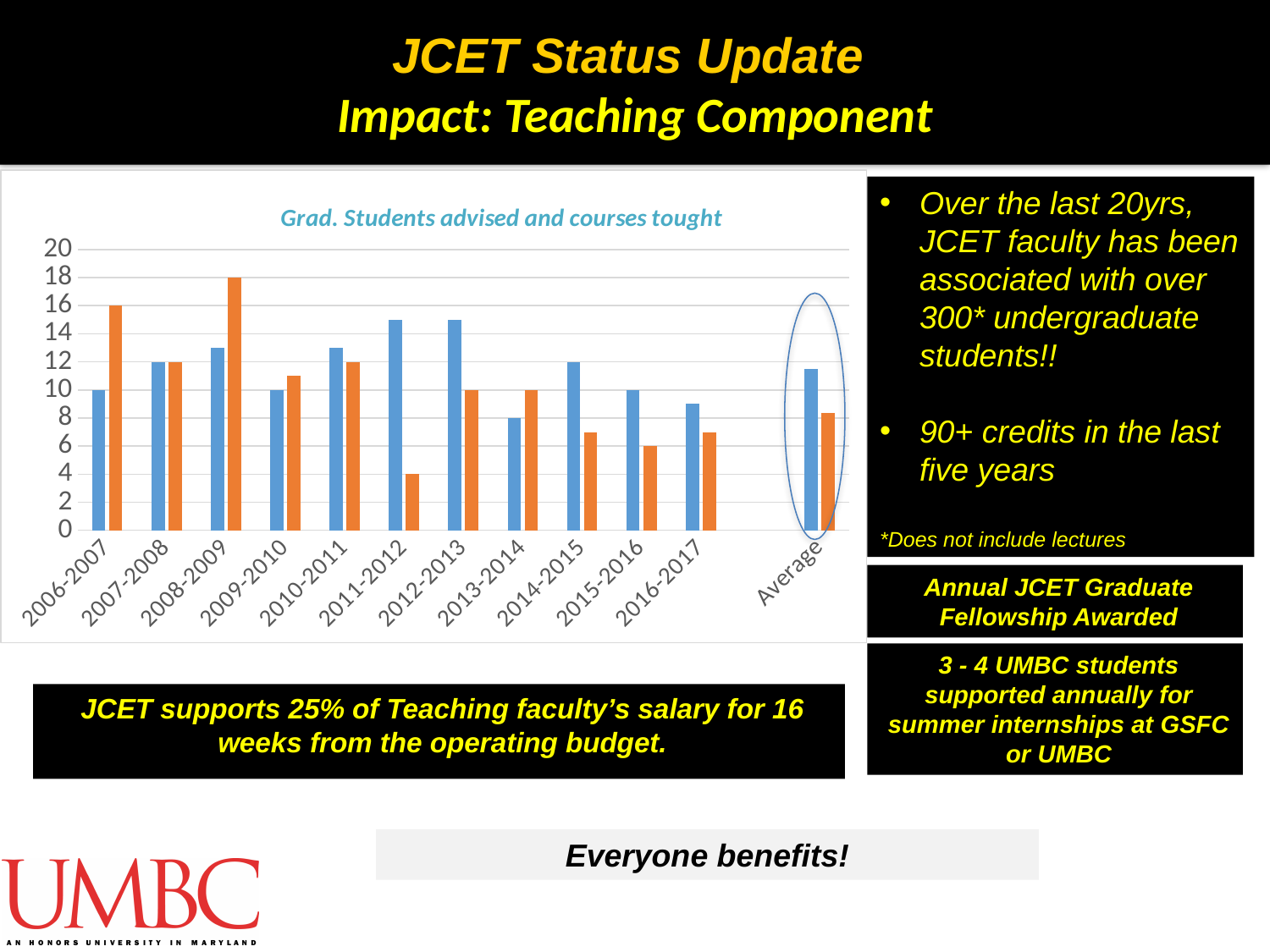
How many categories are shown along the x axis of the chart? 12 What is the value of the blue bar for 2006-2007? 10 What is the value of the orange bar for 2008-2009? 18 What is the value of the orange bar for 2011-2012? 4 Which category has the lowest orange bar? 2011-2012 Is the blue bar for Average greater or less than 10? greater What is the difference between the orange bar and the blue bar for 2006-2007? 6 What is the value of the orange bar for 2006-2007? 16 What is the title of the chart? Grad. Students advised and courses tought Which category has the highest orange bar? 2008-2009 What kind of chart is shown on the slide? bar chart What is the value of the blue bar for 2013-2014? 8